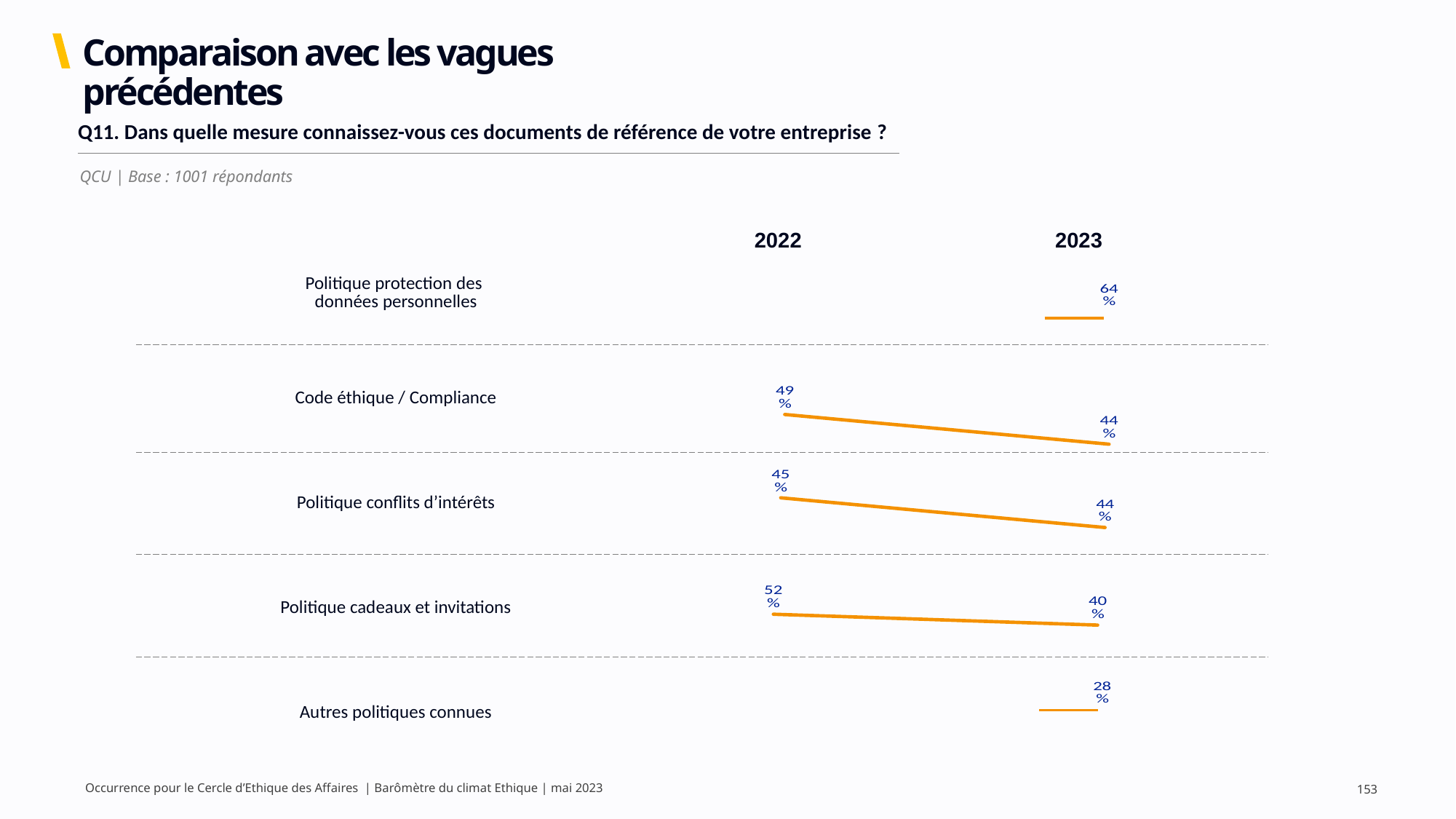
Which is larger: the 2022 value for "Politique cadeaux et invitations" or the 2022 value for "Code éthique / Compliance"? Politique cadeaux et invitations (52%) What is the 2023 value for "Politique protection des données personnelles"? 64% How many items (rows) are compared on the slide? 5 What is the 2023 value for "Autres politiques connues"? 28% What is the difference between the 2022 and 2023 values for "Politique conflits d'intérêts"? 1 point (45% to 44%) What is the 2022 value for "Politique cadeaux et invitations"? 52% Which item has the lowest 2023 value? Autres politiques connues Does the value for "Code éthique / Compliance" rise or fall from 2022 to 2023? Fall What is the 2023 value for "Code éthique / Compliance"? 44% Which item has the highest 2023 value? Politique protection des données personnelles By how many percentage points did "Politique cadeaux et invitations" change from 2022 to 2023? 12 points (52% to 40%) What is the 2022 value for "Code éthique / Compliance"? 49%